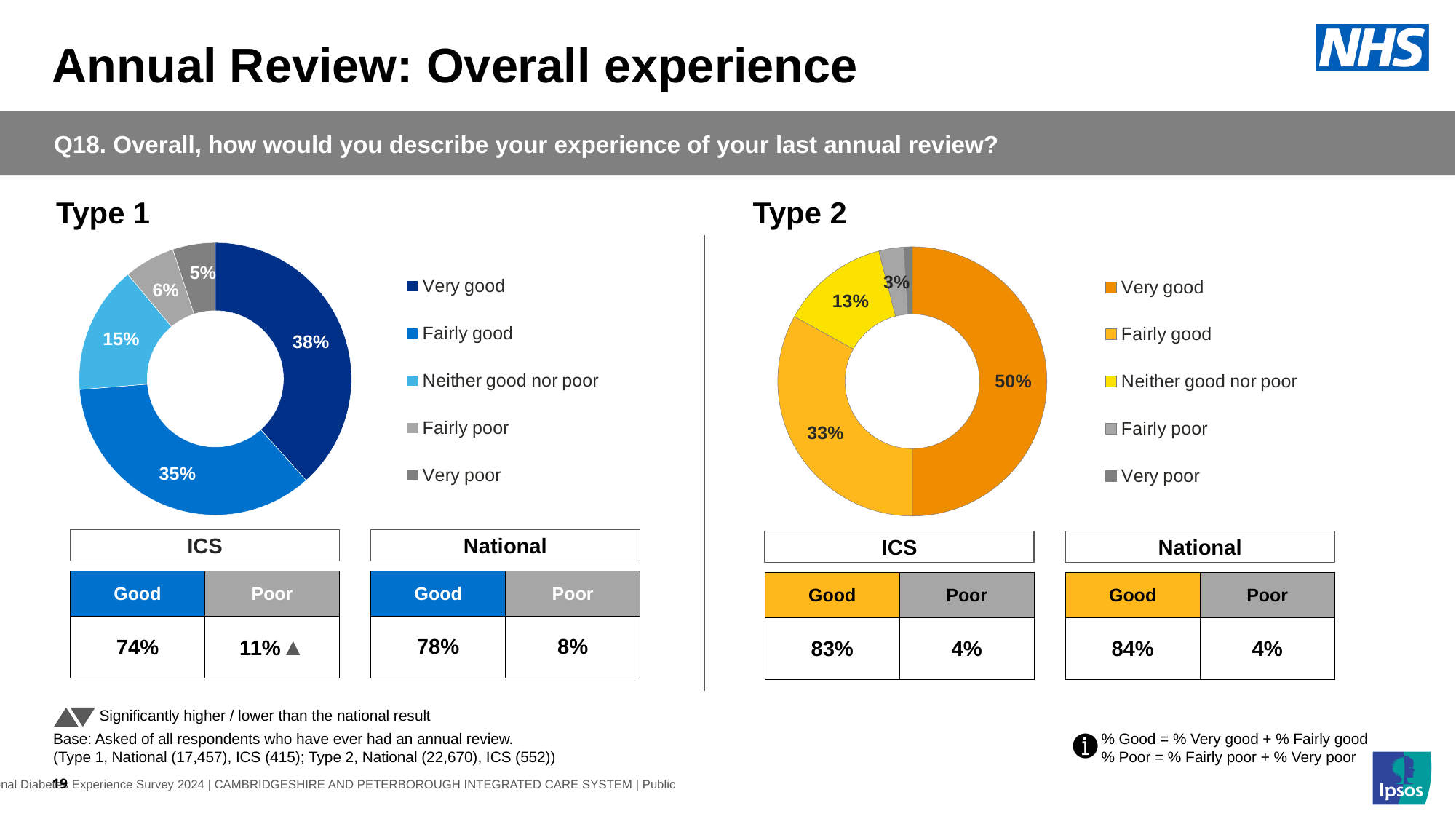
How many response categories does the legend of the Type 1 chart list? 5 In the Type 1 chart, what percentage of respondents described their experience as Very good? 38% In the Type 2 chart, what percentage of respondents described their experience as Very good? 50% In the Type 2 chart, which labelled response category has the smallest share? Fairly poor In the Type 1 chart, what colour is the Very good segment? Dark blue In the Type 1 chart, what percentage of respondents said Neither good nor poor? 15% In the Type 2 chart, what is the difference in percentage points between Very good and Neither good nor poor? 37 What kind of chart is used to show the Type 2 results? Donut (pie) chart In the Type 1 chart, which response category has the largest share? Very good In the Type 2 chart, what percentage of respondents said Fairly good? 33% In the Type 1 chart, what is the difference in percentage points between Very good and Fairly good? 3 Which chart has the larger Very good share, Type 1 or Type 2? Type 2